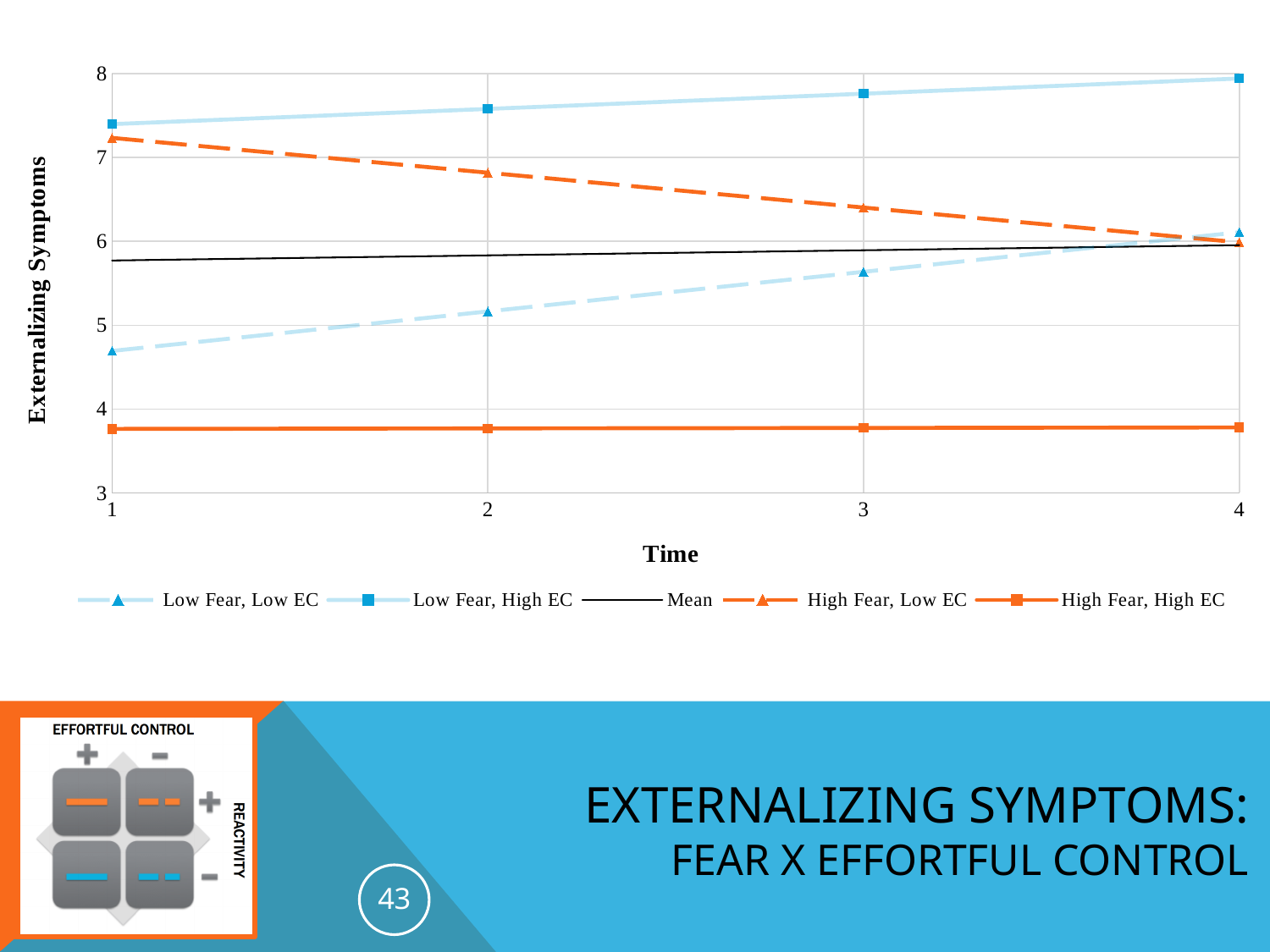
Is the value for Low Fear, Low EC at Time 1 greater or less than 5? less How many series does the legend list? 5 How many time points are plotted along the x axis? 4 Does the Low Fear, Low EC line rise or fall from Time 1 to Time 4? rise Which series has the lowest value at Time 2? High Fear, High EC What kind of chart is shown on the slide? line chart Is the value for Low Fear, High EC at Time 1 greater or less than 7? greater What is the title of the y axis? Externalizing Symptoms At Time 1, which is larger: Low Fear, High EC or High Fear, High EC? Low Fear, High EC Does the High Fear, Low EC line rise or fall from Time 1 to Time 4? fall Is the value for High Fear, High EC at Time 4 greater or less than 4? less Which series has the highest value at Time 4? Low Fear, High EC